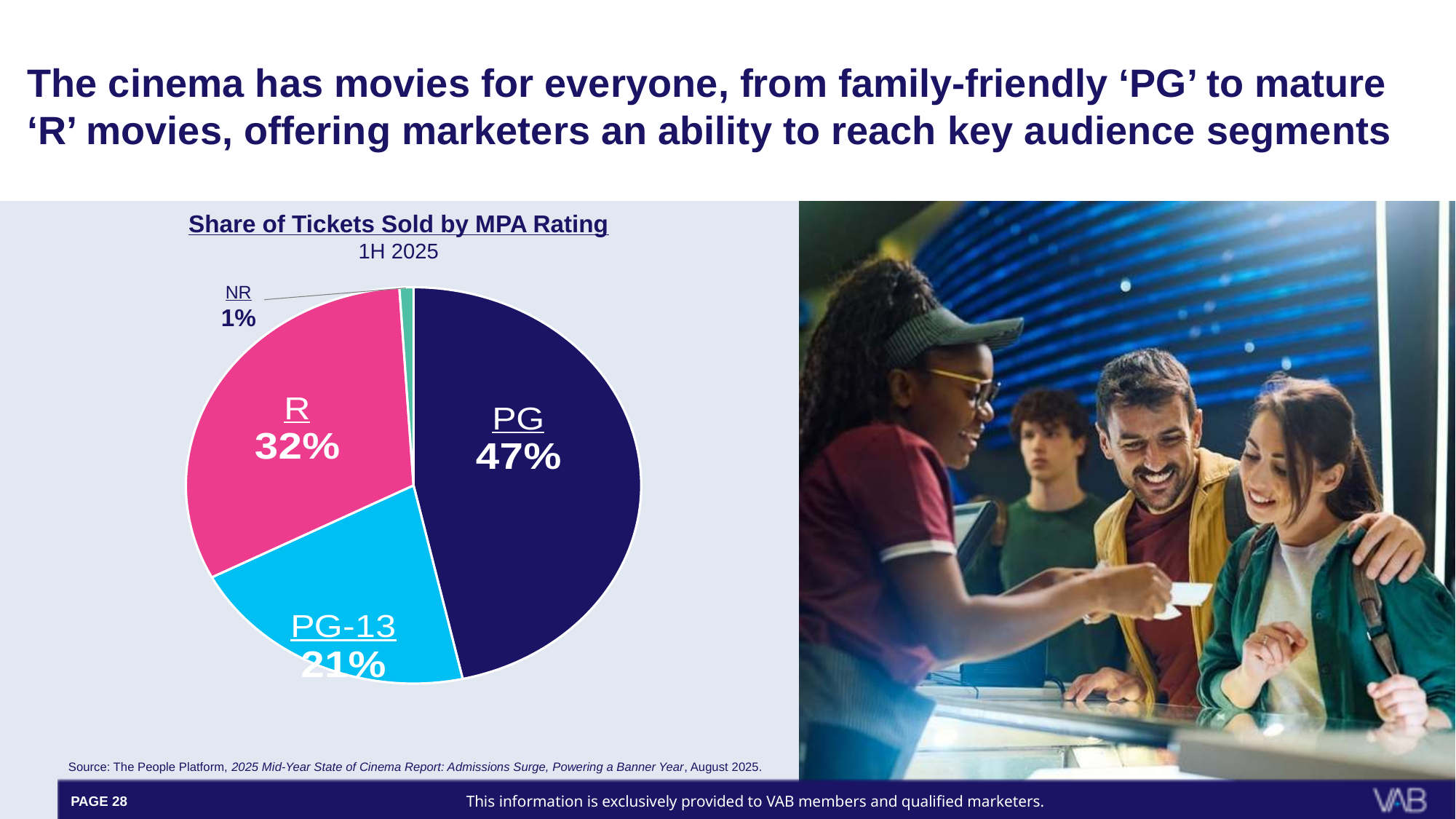
Which MPA rating has the smallest share of tickets sold? NR What time period does the chart cover? 1H 2025 What type of chart is used to show the share of tickets sold by MPA rating? Pie chart How many rating categories are shown in the pie chart? 4 What share of tickets sold is for NR (not rated) movies? 1% What is the title of the chart? Share of Tickets Sold by MPA Rating What share of tickets sold is for PG-rated movies? 47% What is the difference in share between PG and R? 15 percentage points What share of tickets sold is for PG-13 movies? 21% What share of tickets sold is for R-rated movies? 32% Which MPA rating has the largest share of tickets sold? PG Which has a larger share of tickets sold, R or PG-13? R